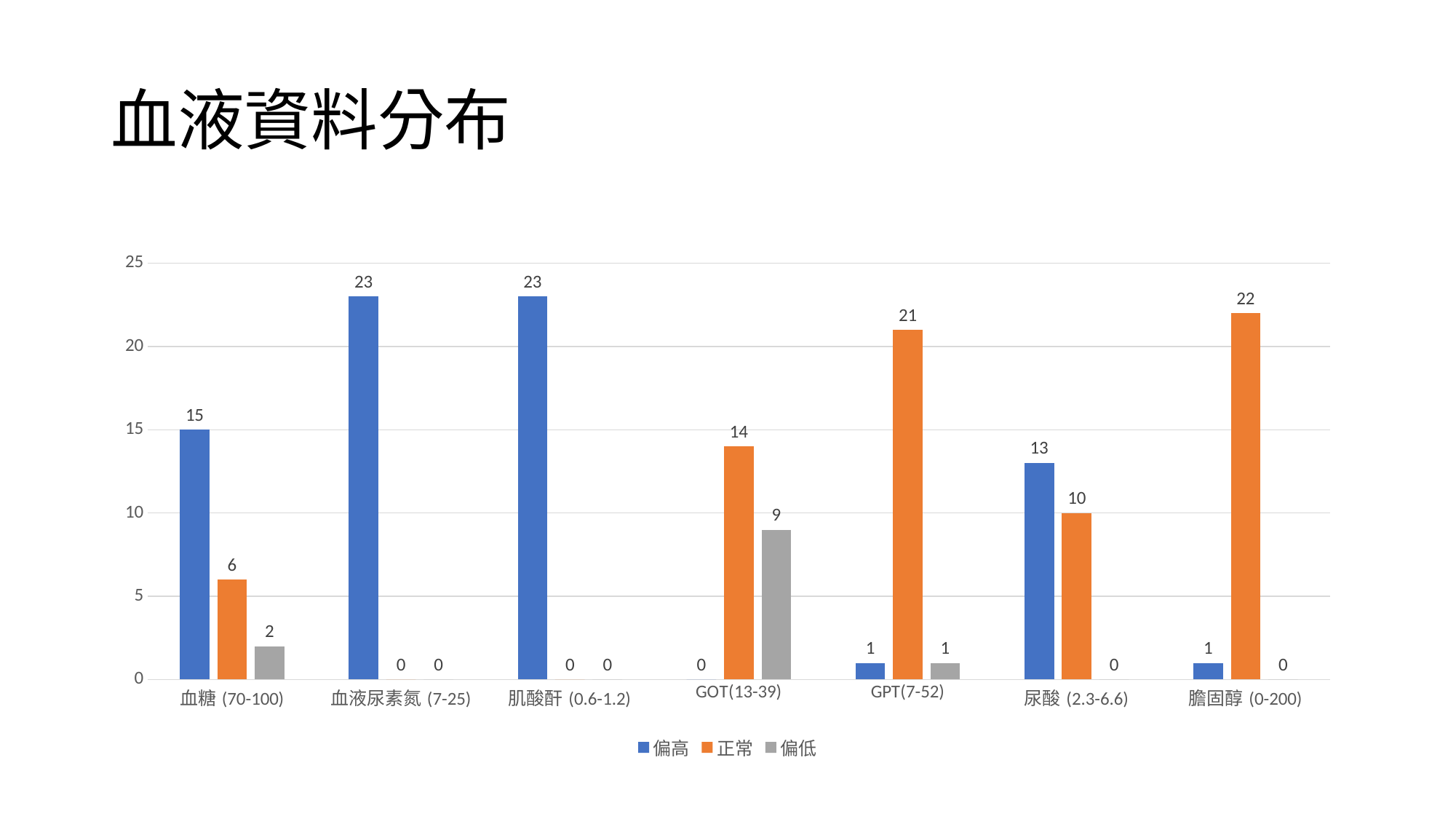
What is the 正常 value for 膽固醇 (0-200)? 22 What is the title of the slide? 血液資料分布 What kind of chart is shown on the slide? Bar chart How many series does the legend list? 3 What is the difference between the 偏高 and 正常 values for 尿酸 (2.3-6.6)? 3 What is the 偏高 value for 血糖 (70-100)? 15 Which category has the highest 正常 value? 膽固醇 (0-200) Which category has the lowest 偏高 value? GOT(13-39) How many categories are shown on the x axis? 7 What is the 偏低 value for GOT(13-39)? 9 What is the 正常 value for GPT(7-52)? 21 Which is larger for 血糖 (70-100): the 偏高 value or the 正常 value? 偏高